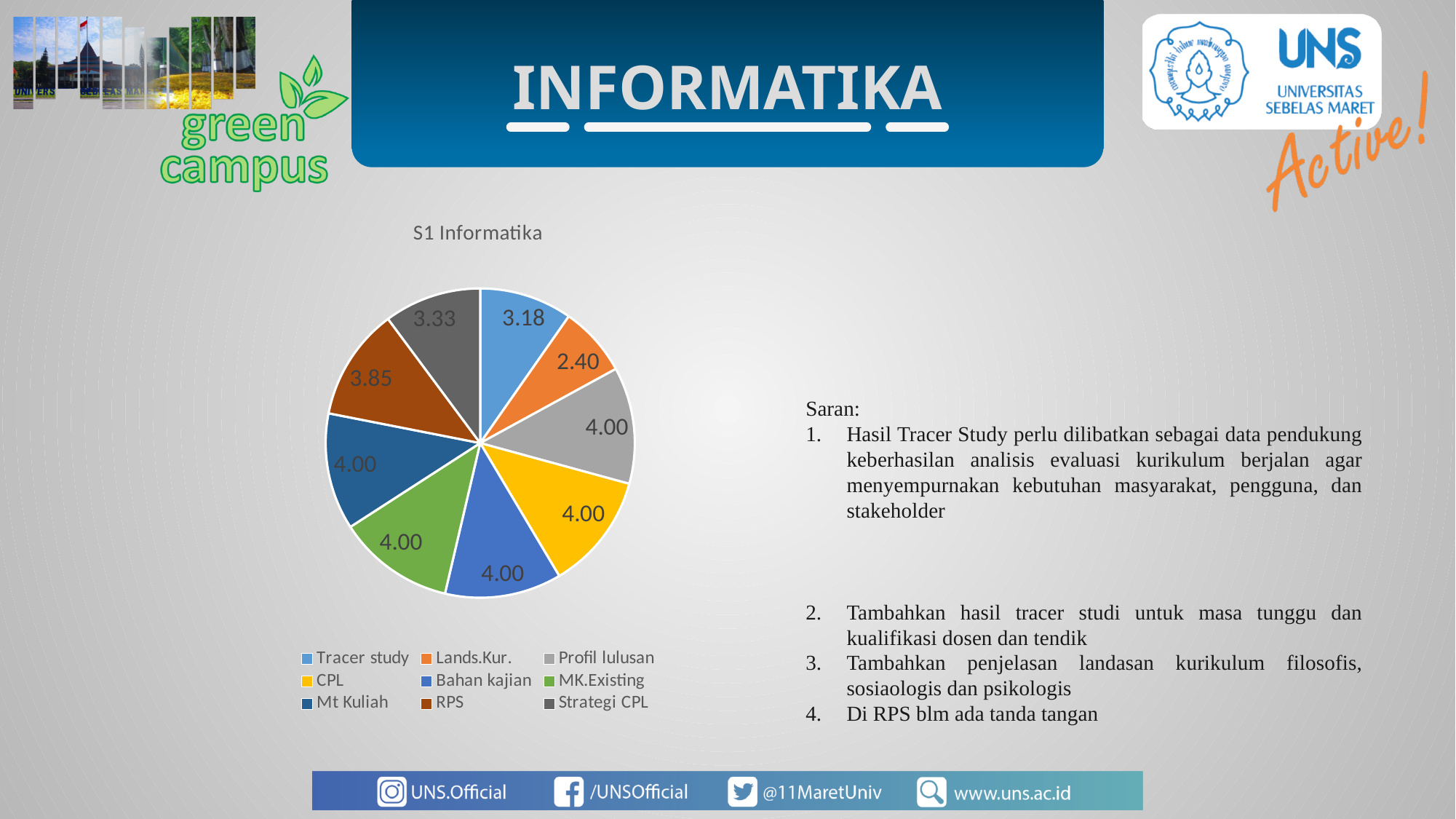
What is the difference between the values for RPS and Strategi CPL in the S1 Informatika pie chart? 0.52 What is the difference between the values for Tracer study and Lands.Kur. in the S1 Informatika pie chart? 0.78 What is the value for Tracer study in the S1 Informatika pie chart? 3.18 What type of chart is shown on the slide? Pie chart Which is larger in the S1 Informatika pie chart, RPS or Strategi CPL? RPS Which category has the lowest value in the S1 Informatika pie chart? Lands.Kur. What is the title of the chart on the slide? S1 Informatika What is the value for RPS in the S1 Informatika pie chart? 3.85 What is the value for Strategi CPL in the S1 Informatika pie chart? 3.33 What is the value for Lands.Kur. in the S1 Informatika pie chart? 2.40 What is the value for CPL in the S1 Informatika pie chart? 4.00 How many categories are shown in the S1 Informatika pie chart? 9